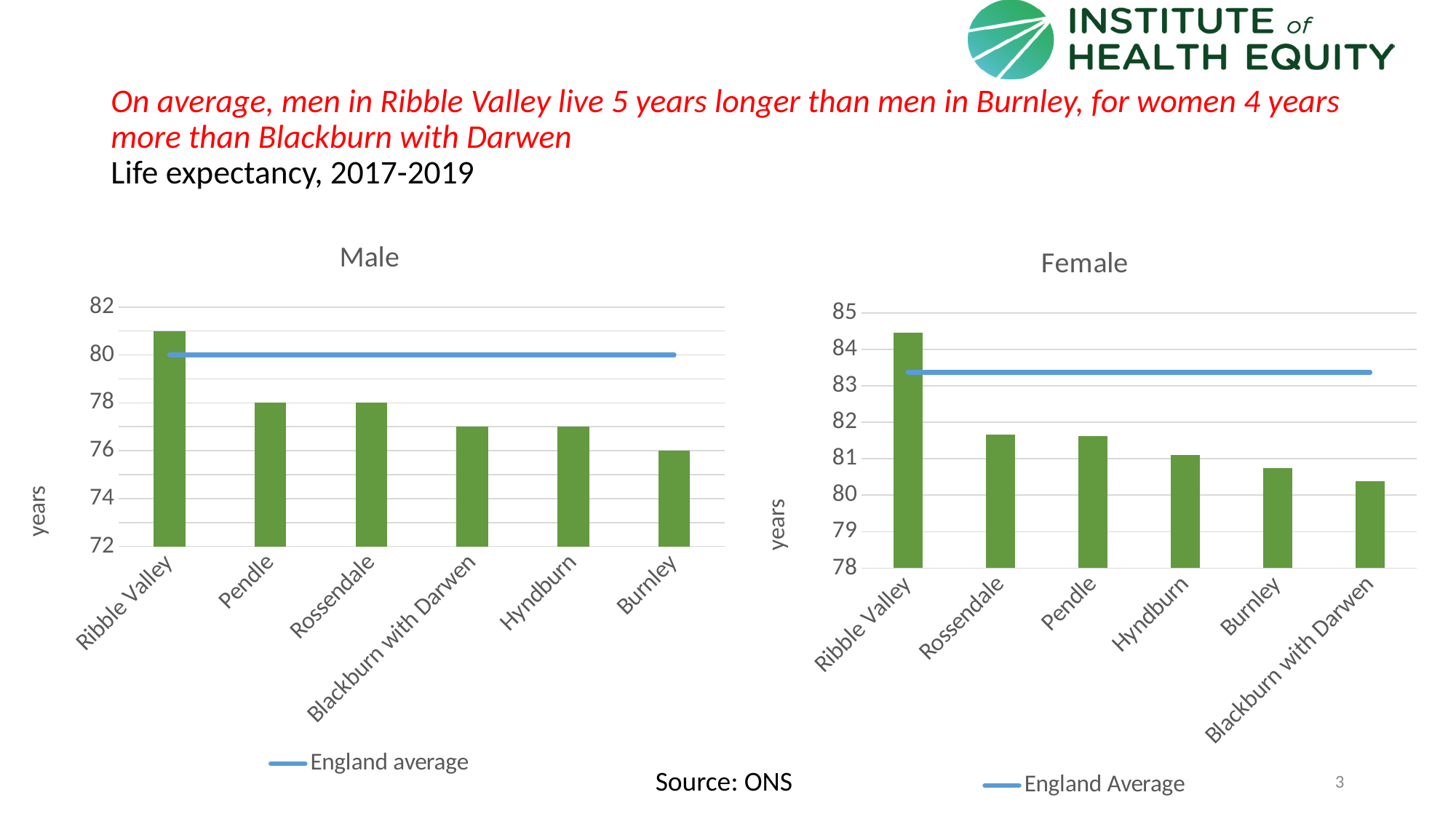
In the Female chart, is the value for Ribble Valley greater or less than 84? greater In the Male chart, which area has the highest life expectancy? Ribble Valley What kind of chart is the Male chart? bar chart In the Male chart, is the value for Ribble Valley larger or smaller than the value for Burnley? larger In the Male chart, which area has the lowest life expectancy? Burnley In the Male chart, is the value for Ribble Valley greater or less than 80? greater In the Female chart, is the value for Blackburn with Darwen greater or less than 81? less How many areas are shown in the Female chart? 6 In the Female chart, which area has the highest life expectancy? Ribble Valley In the Female chart, do the bar values rise or fall from left to right? fall In the Female chart, which area has the lowest life expectancy? Blackburn with Darwen